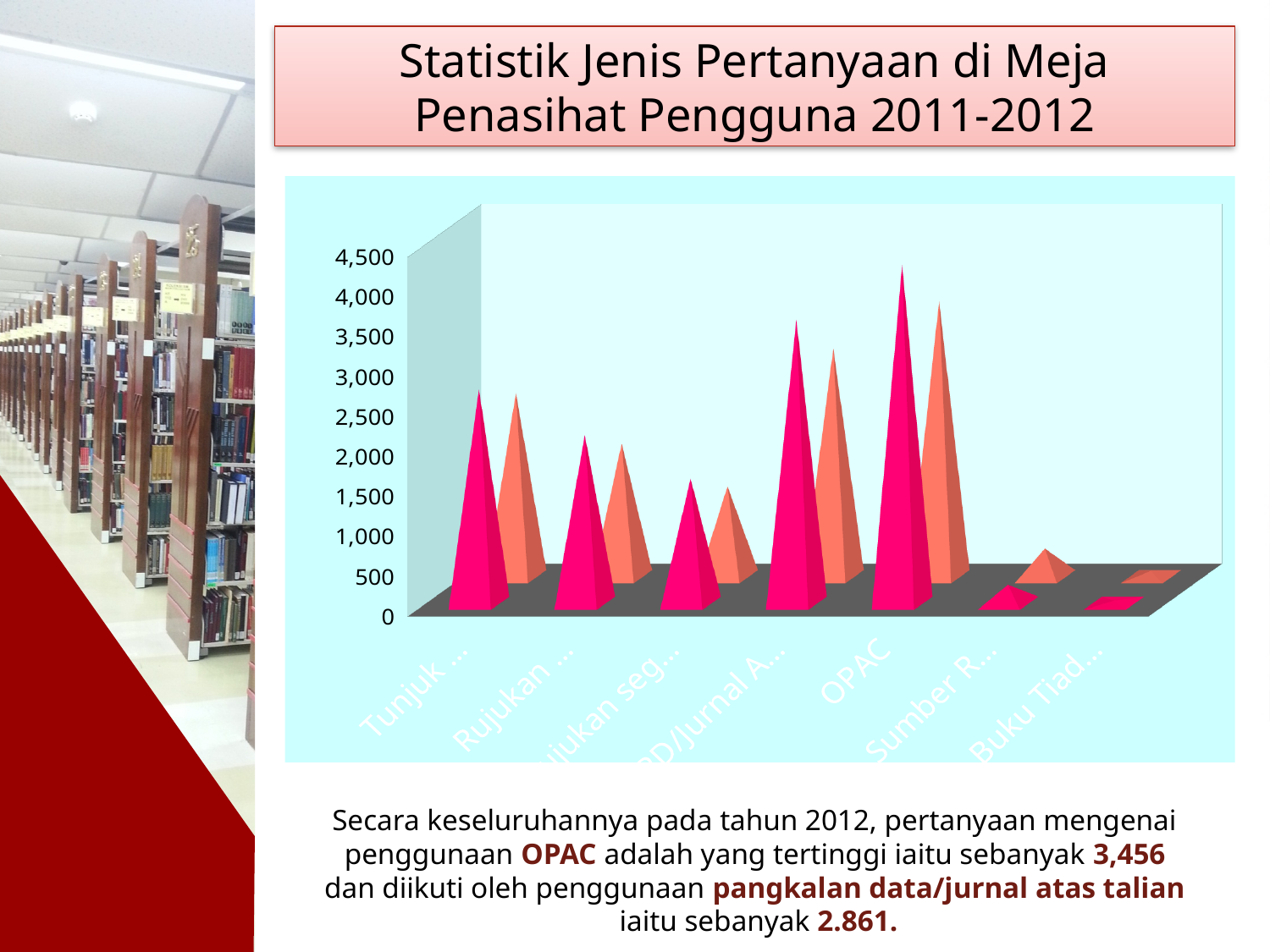
What is the highest tick value shown on the vertical axis of the chart? 4,500 How many data series are plotted in the chart? 2 Which category has the highest value in the chart? OPAC Is the pink value for Tunjuk ... greater or less than 1,500? greater Is the pink value for OPAC greater or less than 3,000? greater What is the title of the slide's chart? Statistik Jenis Pertanyaan di Meja Penasihat Pengguna 2011-2012 What kind of chart is shown on the slide? bar chart Is the pink value for Sumber R... greater or less than 500? less Which is larger, the pink value for Rujukan ... or the pink value for Rujukan seg...? Rujukan ... Which is larger, the pink value for OPAC or the pink value for Tunjuk ...? OPAC How many categories are shown along the x axis of the chart? 7